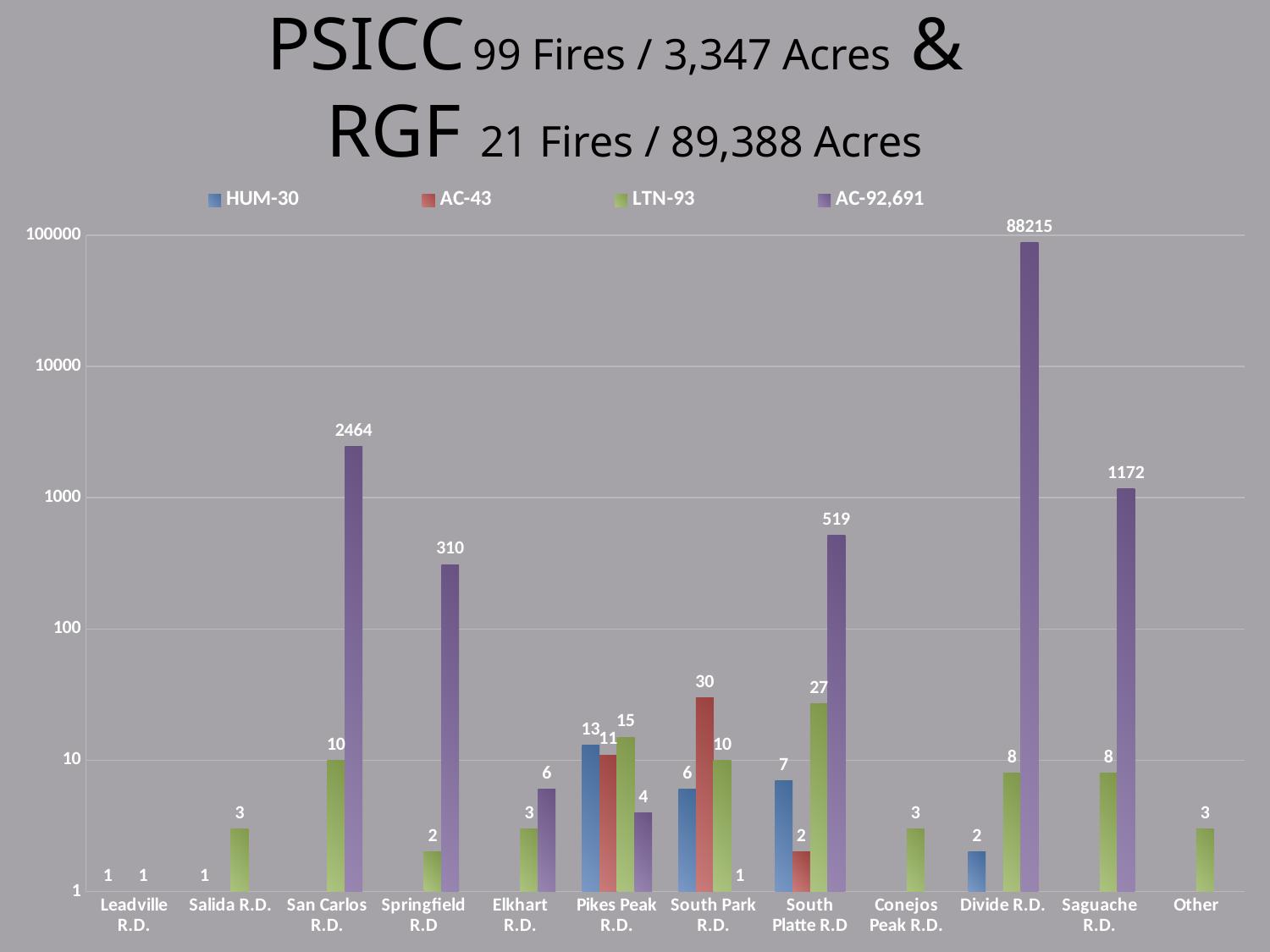
What is the AC-92,691 value for Springfield R.D? 310 How many ranger district categories are shown along the x axis? 12 What is the difference between the LTN-93 and HUM-30 values for Pikes Peak R.D.? 2 Which is larger, the AC-92,691 value for San Carlos R.D. or for Saguache R.D.? San Carlos R.D. What is the AC-92,691 value for Divide R.D.? 88215 What is the AC-43 value for South Park R.D.? 30 Which category has the highest AC-92,691 value? Divide R.D. Is the AC-92,691 value for South Platte R.D greater or less than 100? greater How many series does the legend list? 4 Which series is shown in purple in the legend? AC-92,691 What is the LTN-93 value for South Platte R.D? 27 What kind of chart is shown on the slide? bar chart